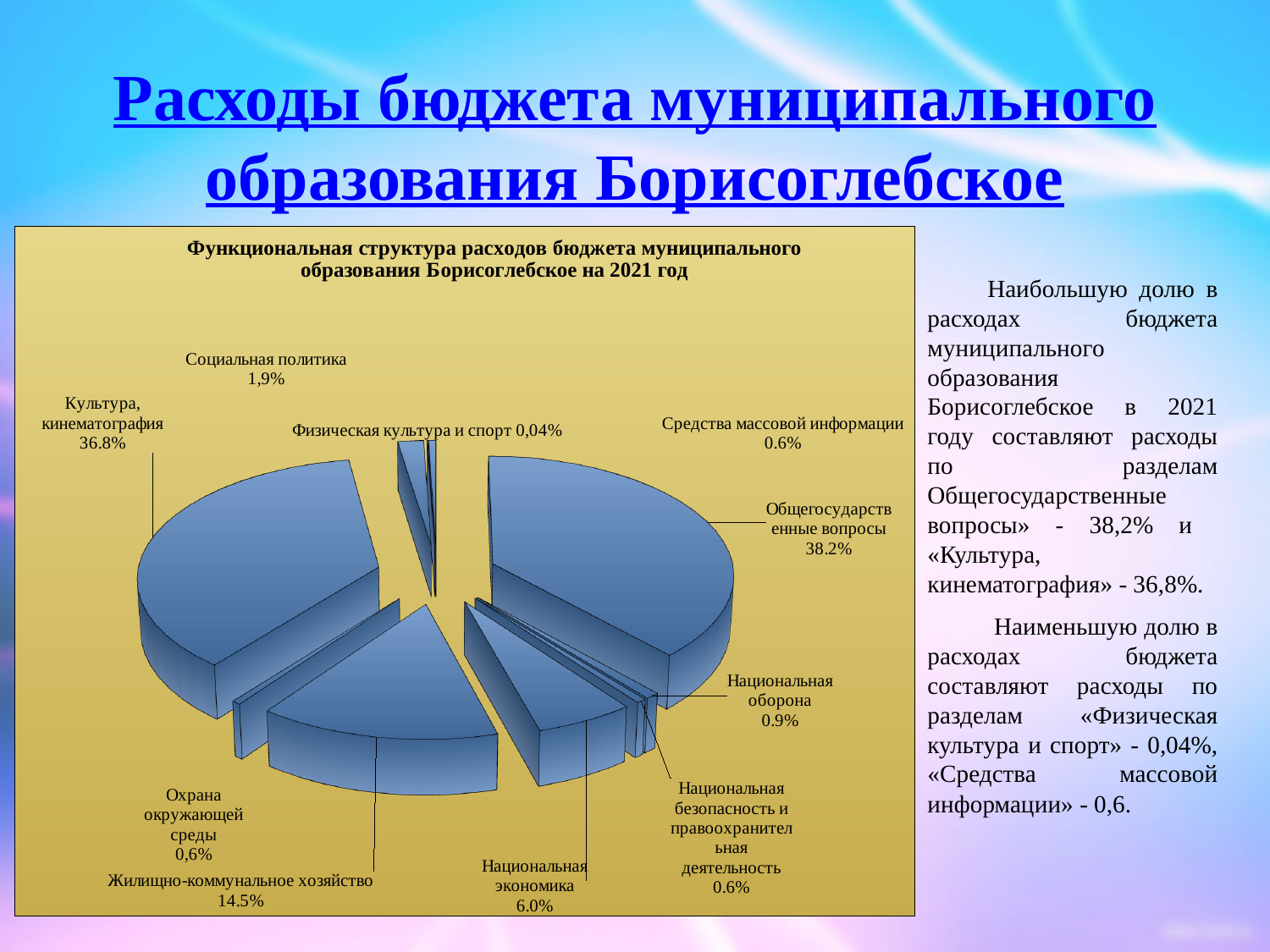
What type of chart is shown on the slide? Pie chart Which is larger: the share for Жилищно-коммунальное хозяйство or for Национальная экономика? Жилищно-коммунальное хозяйство What share of expenditures is labelled for Общегосударственные вопросы? 38.2% What is the difference between the shares for Общегосударственные вопросы and Культура, кинематография? 1.4% What share is shown for Культура, кинематография? 36.8% What share is shown for Национальная экономика? 6.0% Which category has the smallest share of the pie? Физическая культура и спорт What share is shown for Физическая культура и спорт? 0,04% How many categories are shown in the pie chart? 10 What share is shown for Жилищно-коммунальное хозяйство? 14.5% Which category has the largest share of the pie? Общегосударственные вопросы What is the title of the chart? Функциональная структура расходов бюджета муниципального образования Борисоглебское на 2021 год